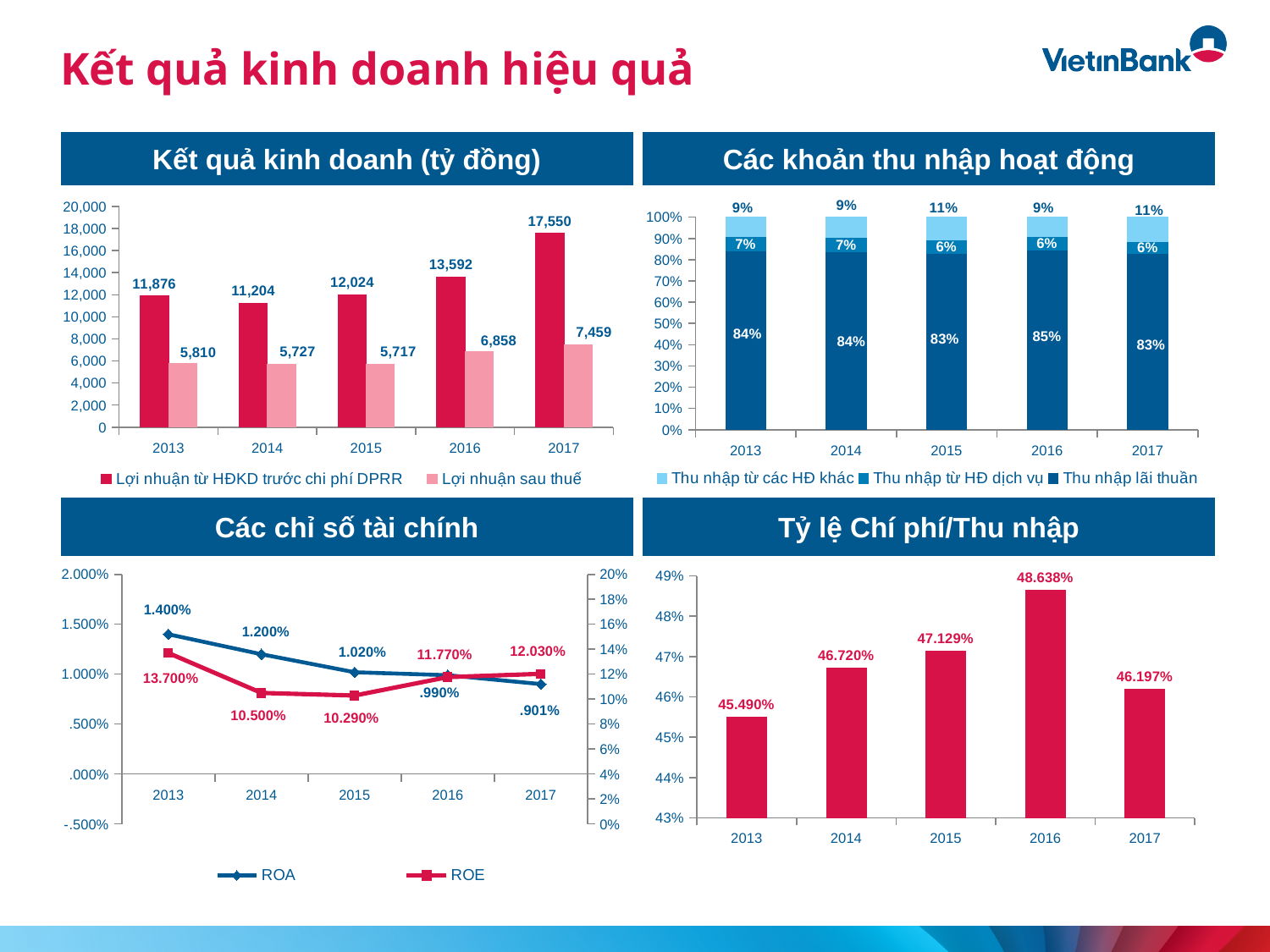
In the chart titled "Kết quả kinh doanh (tỷ đồng)", which year has the lowest Lợi nhuận sau thuế? 2015 In the chart titled "Kết quả kinh doanh (tỷ đồng)", what is the difference between Lợi nhuận từ HĐKD trước chi phí DPRR and Lợi nhuận sau thuế in 2016? 6,734 In the chart titled "Các khoản thu nhập hoạt động", what is the share of Thu nhập từ các HĐ khác in 2015? 11% How many series does the legend of the chart titled "Các khoản thu nhập hoạt động" list? 3 How many series does the legend of the chart titled "Kết quả kinh doanh (tỷ đồng)" list? 2 In the chart titled "Các khoản thu nhập hoạt động", what is the share of Thu nhập lãi thuần in 2016? 85% In the chart titled "Các chỉ số tài chính", what is the ROE value for 2014? 10.500% In the chart titled "Tỷ lệ Chí phí/Thu nhập", what is the value for 2013? 45.490% What kind of chart is the chart titled "Tỷ lệ Chí phí/Thu nhập"? bar chart In the chart titled "Các chỉ số tài chính", does ROA rise or fall from 2013 to 2017? fall In the chart titled "Kết quả kinh doanh (tỷ đồng)", what is the value of Lợi nhuận từ HĐKD trước chi phí DPRR in 2017? 17,550 In the chart titled "Tỷ lệ Chí phí/Thu nhập", which year has the highest value? 2016